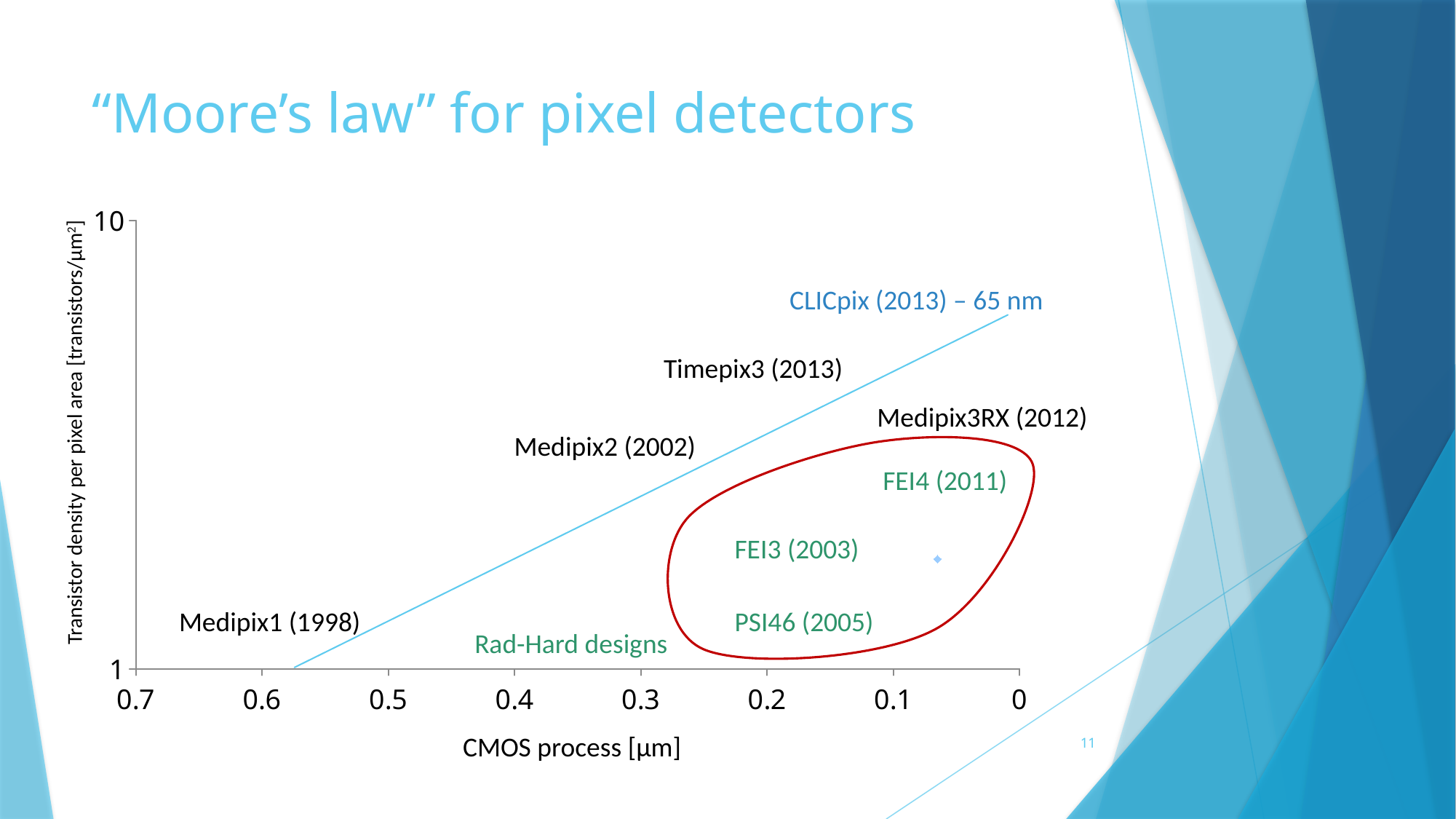
Which labelled detector has the lowest transistor density per pixel area on the chart? Medipix1 (1998) Is the transistor density for CLICpix (2013) greater or less than 1 transistor/µm²? greater Is the transistor density for Medipix1 (1998) greater or less than 10 transistors/µm²? less What kind of chart is shown on the slide? scatter chart What is the title of the chart on the slide? "Moore's law" for pixel detectors Which has a higher transistor density per pixel area, Timepix3 (2013) or Medipix2 (2002)? Timepix3 (2013) Does the transistor density per pixel area rise or fall as the CMOS process size decreases along the x axis? rise How many named pixel detectors are labelled on the chart? 8 Which has a higher transistor density per pixel area, CLICpix (2013) or Medipix1 (1998)? CLICpix (2013) What is the label of the x axis of the chart? CMOS process [µm] How many detectors are enclosed in the red outline labelled "Rad-Hard designs"? 3 Which labelled detector has the highest transistor density per pixel area on the chart? CLICpix (2013)